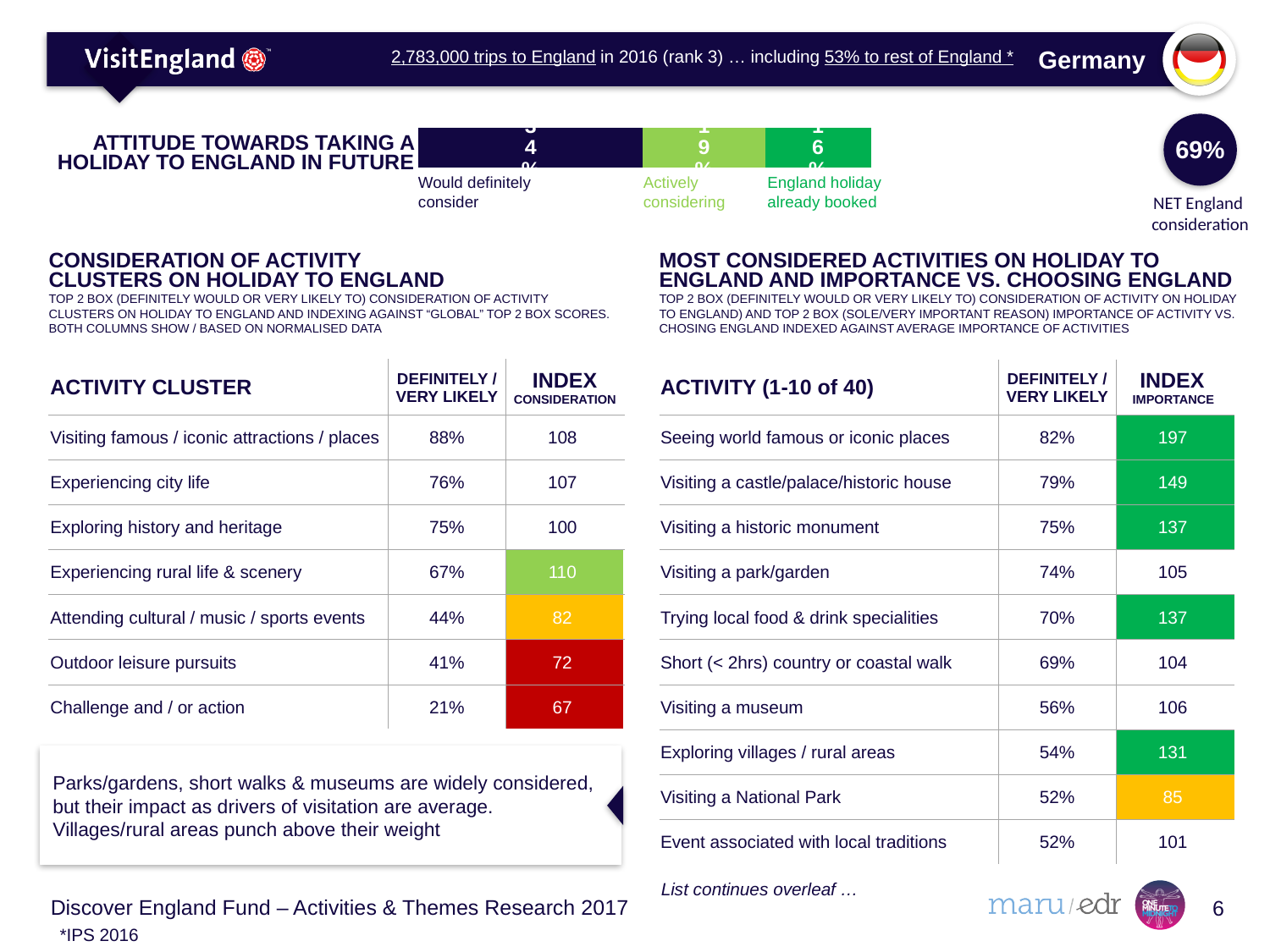
In the 'Attitude towards taking a holiday to England in future' chart, which is larger: 'Actively considering' or 'England holiday already booked'? Actively considering How many segments make up the 'Attitude towards taking a holiday to England in future' bar? 3 In the 'Attitude towards taking a holiday to England in future' chart, which is larger: 'Would definitely consider' or 'Actively considering'? Would definitely consider In the 'Attitude towards taking a holiday to England in future' chart, which segment is the largest? Would definitely consider In the 'Attitude towards taking a holiday to England in future' chart, which segment is the smallest? England holiday already booked What is the title of the stacked bar chart at the top of the slide? Attitude towards taking a holiday to England in future What kind of chart is used for 'Attitude towards taking a holiday to England in future'? bar chart What NET England consideration figure is shown beside the 'Attitude towards taking a holiday to England in future' chart? 69%